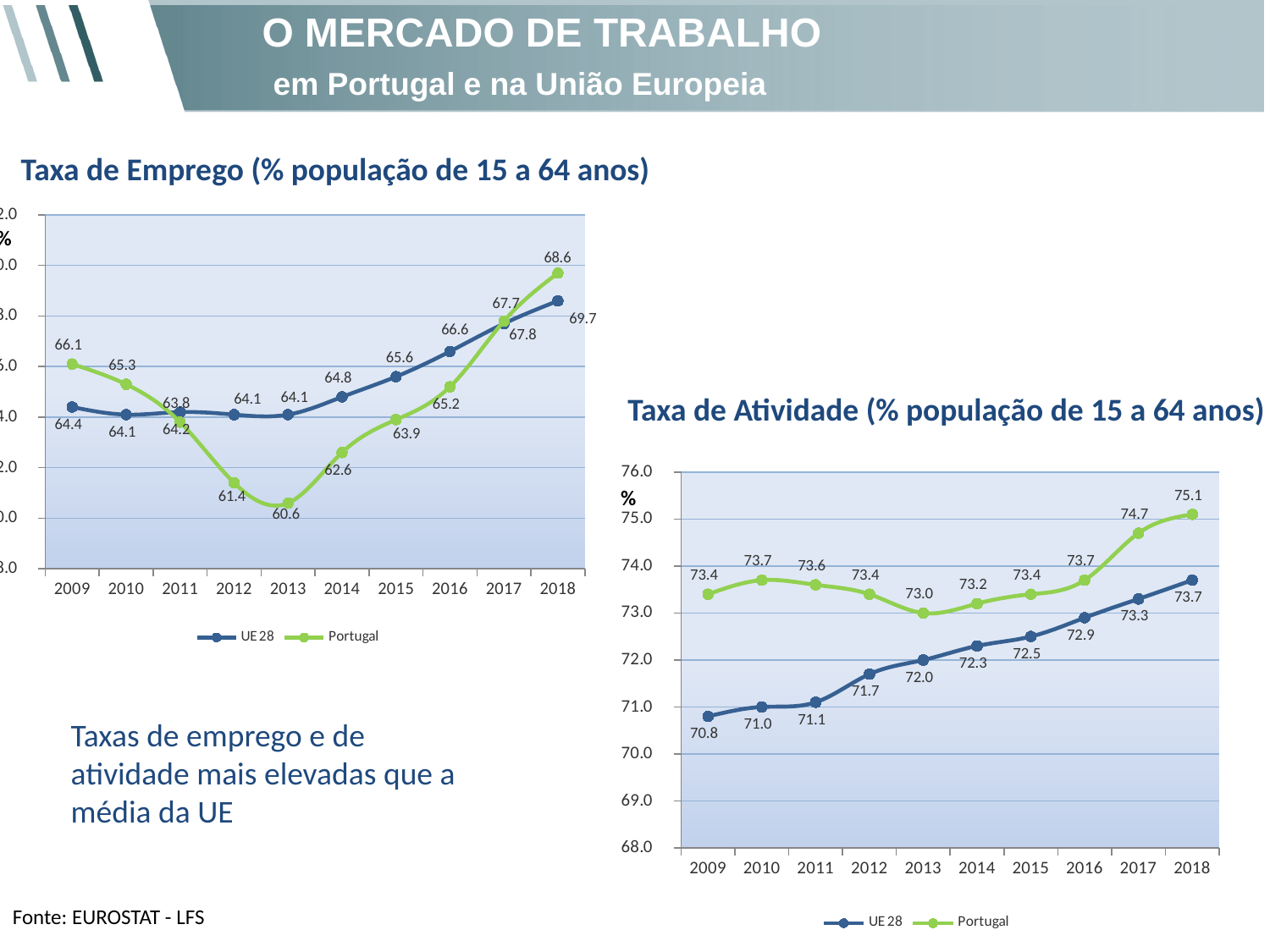
In the 'Taxa de Emprego' chart, which series has the higher value in 2012, UE 28 or Portugal? UE 28 What kind of chart is the 'Taxa de Emprego' chart? line chart How many years are shown on the x axis of the 'Taxa de Atividade' chart? 10 In the 'Taxa de Emprego' chart, what is the value for Portugal in 2013? 60.6 In the 'Taxa de Atividade' chart, what is the value for UE 28 in 2009? 70.8 In the 'Taxa de Atividade' chart, in which year does the Portugal series reach its highest value? 2018 In the 'Taxa de Atividade' chart, what is the value for Portugal in 2013? 73.0 In the 'Taxa de Emprego' chart, what is the value for UE 28 in 2015? 65.6 In the 'Taxa de Atividade' chart, does the UE 28 series rise or fall from 2009 to 2018? rise In the 'Taxa de Emprego' chart, what is the difference between the Portugal values in 2009 and 2013? 5.5 In the 'Taxa de Atividade' chart, what is the difference between Portugal and UE 28 in 2018? 1.4 In the 'Taxa de Emprego' chart, in which year is the Portugal series at its lowest? 2013